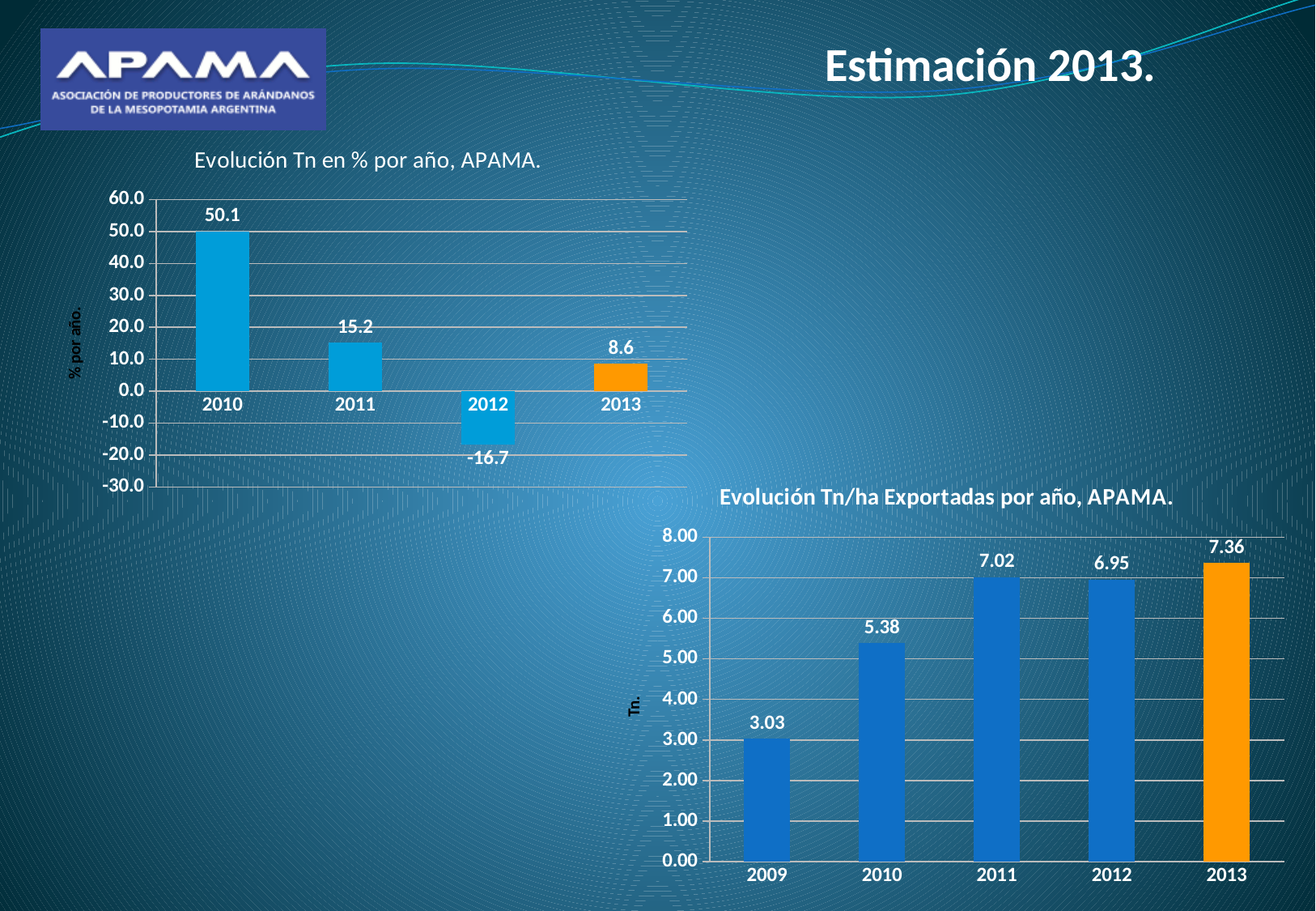
What kind of chart is 'Evolución Tn/ha Exportadas por año, APAMA.'? Bar chart In the chart 'Evolución Tn en % por año, APAMA.', what is the value for 2012? -16.7 In the chart 'Evolución Tn/ha Exportadas por año, APAMA.', what is the difference between the values for 2010 and 2009? 2.35 In the chart 'Evolución Tn/ha Exportadas por año, APAMA.', what is the value for 2009? 3.03 In the chart 'Evolución Tn/ha Exportadas por año, APAMA.', which year has the highest value? 2013 In the chart 'Evolución Tn en % por año, APAMA.', which year has the highest value? 2010 In the chart 'Evolución Tn/ha Exportadas por año, APAMA.', is the value for 2011 larger than the value for 2012? Yes In the chart 'Evolución Tn/ha Exportadas por año, APAMA.', what is the value for 2013? 7.36 In the chart 'Evolución Tn en % por año, APAMA.', what is the difference between the values for 2010 and 2011? 34.9 In the chart 'Evolución Tn en % por año, APAMA.', what is the value for 2010? 50.1 In the chart 'Evolución Tn en % por año, APAMA.', how many years are shown? 4 In the chart 'Evolución Tn en % por año, APAMA.', which year has the lowest value? 2012